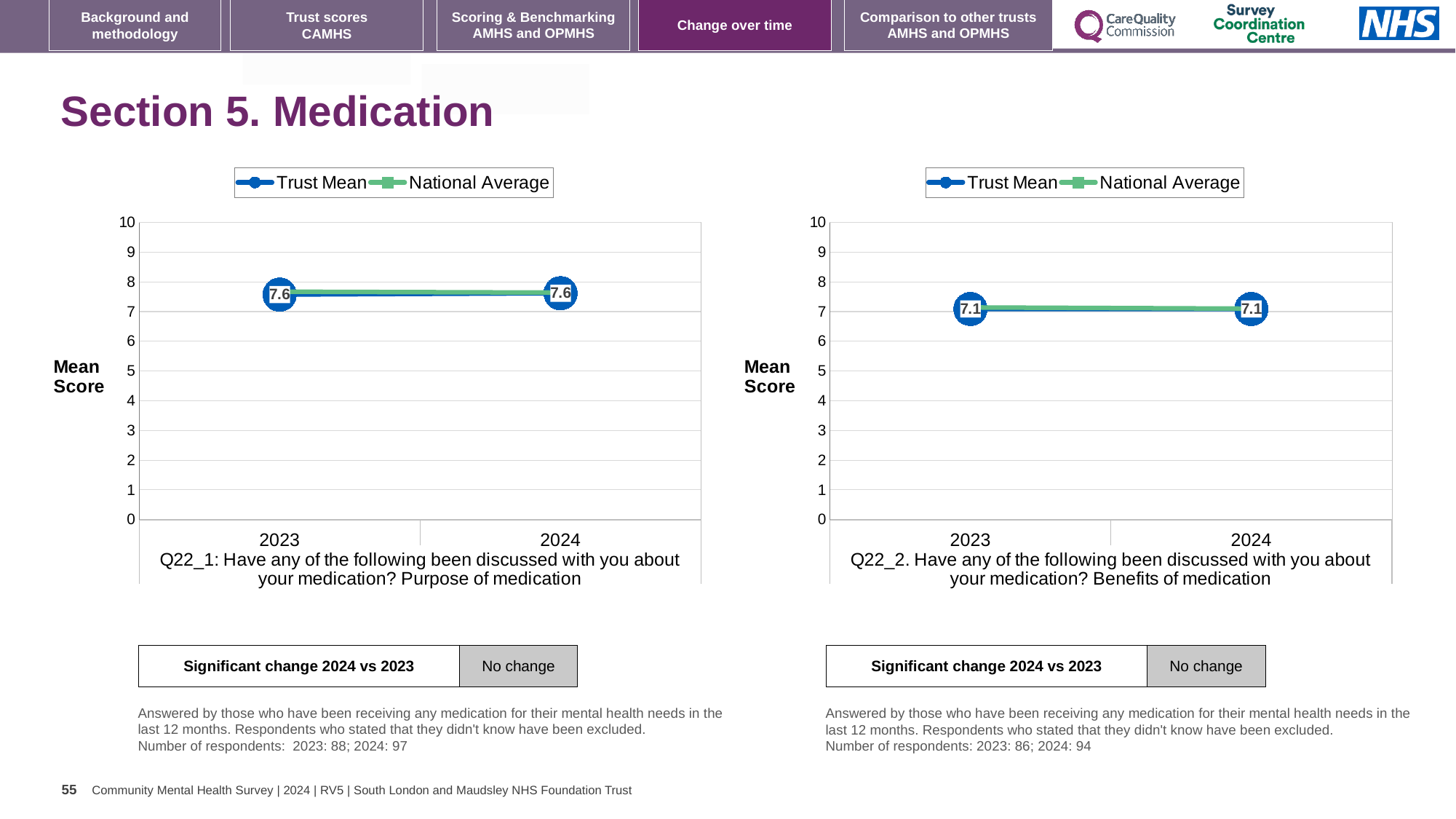
In the right chart (Q22_2: Benefits of medication), what is the Trust Mean score for 2023? 7.1 In the right chart (Q22_2: Benefits of medication), what is the Trust Mean score for 2024? 7.1 In the left chart (Q22_1: Purpose of medication), what is the difference between the Trust Mean scores for 2024 and 2023? 0 What kind of chart is the left chart (Q22_1: Purpose of medication)? Line chart What are the two series named in the legend of the right chart (Q22_2: Benefits of medication)? Trust Mean and National Average In the right chart (Q22_2: Benefits of medication), does the Trust Mean rise, fall or stay the same from 2023 to 2024? Stays the same In the left chart (Q22_1: Purpose of medication), is the Trust Mean for 2024 greater or less than 5? greater In the right chart (Q22_2: Benefits of medication), is the National Average for 2023 greater or less than 5? greater In the left chart (Q22_1: Purpose of medication), what is the Trust Mean score for 2023? 7.6 How many years are plotted on the x axis of the right chart (Q22_2: Benefits of medication)? 2 In the left chart (Q22_1: Purpose of medication), what is the Trust Mean score for 2024? 7.6 How many series does the legend of the left chart (Q22_1: Purpose of medication) list? 2